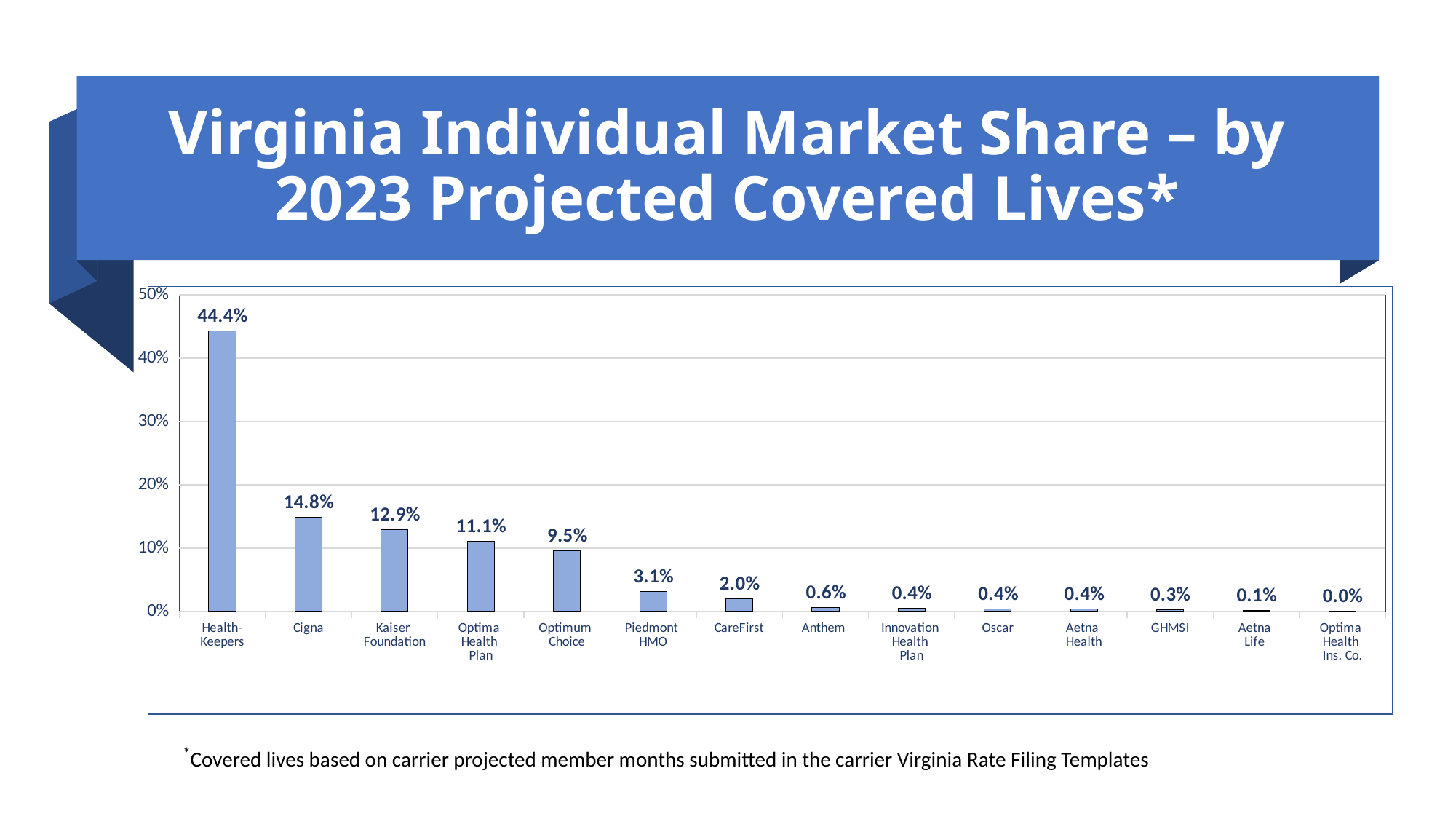
What is the market share for HealthKeepers? 44.4% What is the title of the slide? Virginia Individual Market Share – by 2023 Projected Covered Lives* What is the market share for Kaiser Foundation? 12.9% What is the difference in market share between HealthKeepers and Cigna? 29.6% Which carrier has the lowest market share? Optima Health Ins. Co. Is the value for Cigna greater or less than 10%? greater What is the market share for Piedmont HMO? 3.1% How many carriers are shown on the chart? 14 What kind of chart is shown on the slide? Bar chart Which carrier has the highest market share? HealthKeepers Which has a larger market share, Optima Health Plan or Optimum Choice? Optima Health Plan What is the difference in market share between Cigna and Kaiser Foundation? 1.9%